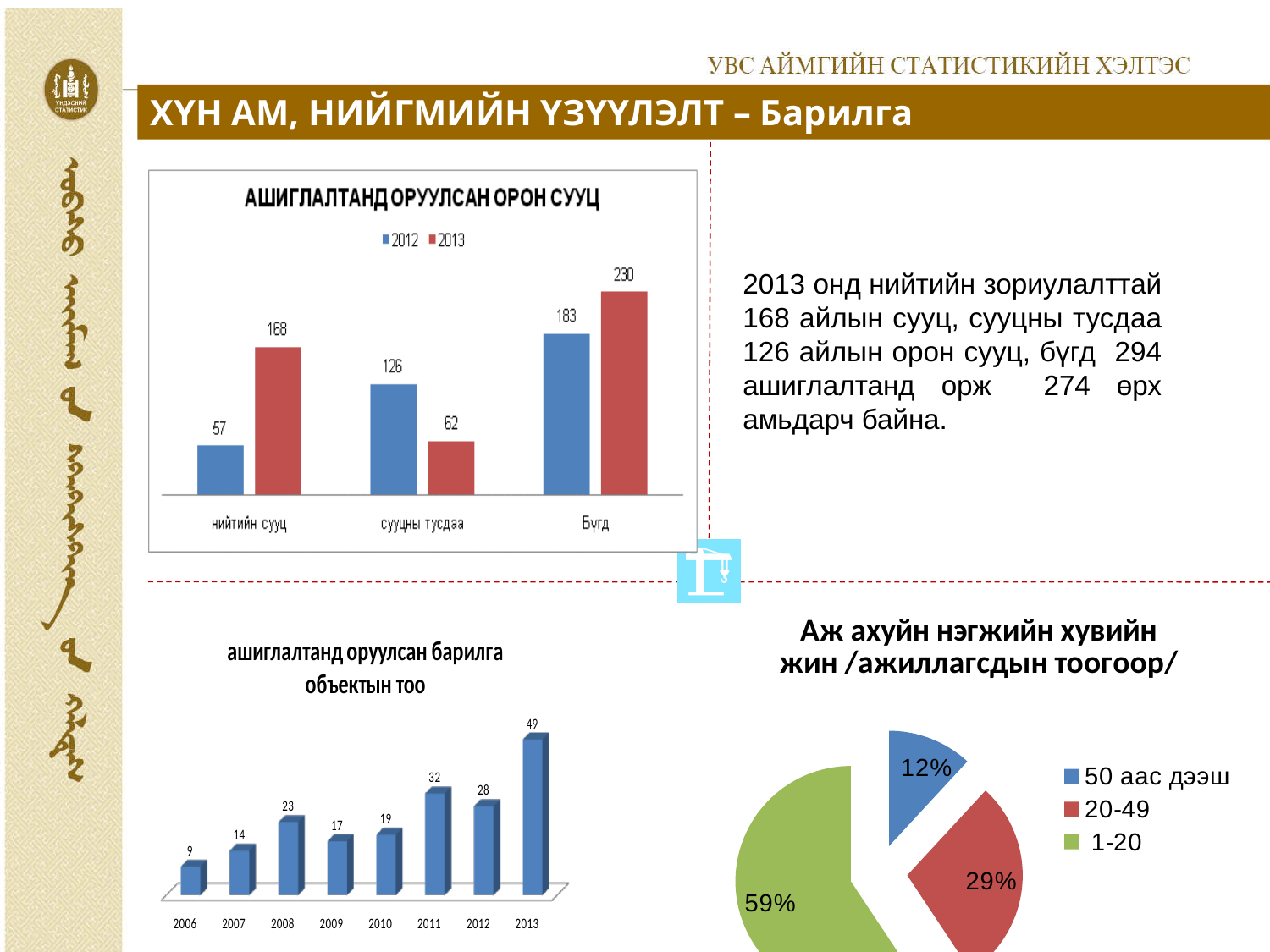
In the chart titled 'АШИГЛАЛТАНД ОРУУЛСАН ОРОН СУУЦ', what is the 2013 value for 'нийтийн сууц'? 168 In the chart titled 'АШИГЛАЛТАНД ОРУУЛСАН ОРОН СУУЦ', which is larger for 'нийтийн сууц': the 2012 value or the 2013 value? 2013 In the chart titled 'ашиглалтанд оруулсан барилга объектын тоо', which year has the highest value? 2013 In the chart titled 'ашиглалтанд оруулсан барилга объектын тоо', which year has the lowest value? 2006 What kind of chart is the one titled 'Аж ахуйн нэгжийн хувийн жин /ажиллагсдын тоогоор/'? pie chart In the chart titled 'АШИГЛАЛТАНД ОРУУЛСАН ОРОН СУУЦ', what is the 2012 value for 'Бүгд'? 183 In the pie chart titled 'Аж ахуйн нэгжийн хувийн жин /ажиллагсдын тоогоор/', what share does the '1-20' slice have? 59% In the chart titled 'АШИГЛАЛТАНД ОРУУЛСАН ОРОН СУУЦ', what is the difference between the 2013 and 2012 values for 'сууцны тусдаа'? 64 In the chart titled 'АШИГЛАЛТАНД ОРУУЛСАН ОРОН СУУЦ', how many series does the legend list? 2 In the chart titled 'ашиглалтанд оруулсан барилга объектын тоо', what is the difference between the values for 2013 and 2012? 21 In the chart titled 'ашиглалтанд оруулсан барилга объектын тоо', how many years are shown on the x axis? 8 In the chart titled 'ашиглалтанд оруулсан барилга объектын тоо', what is the value for 2011? 32